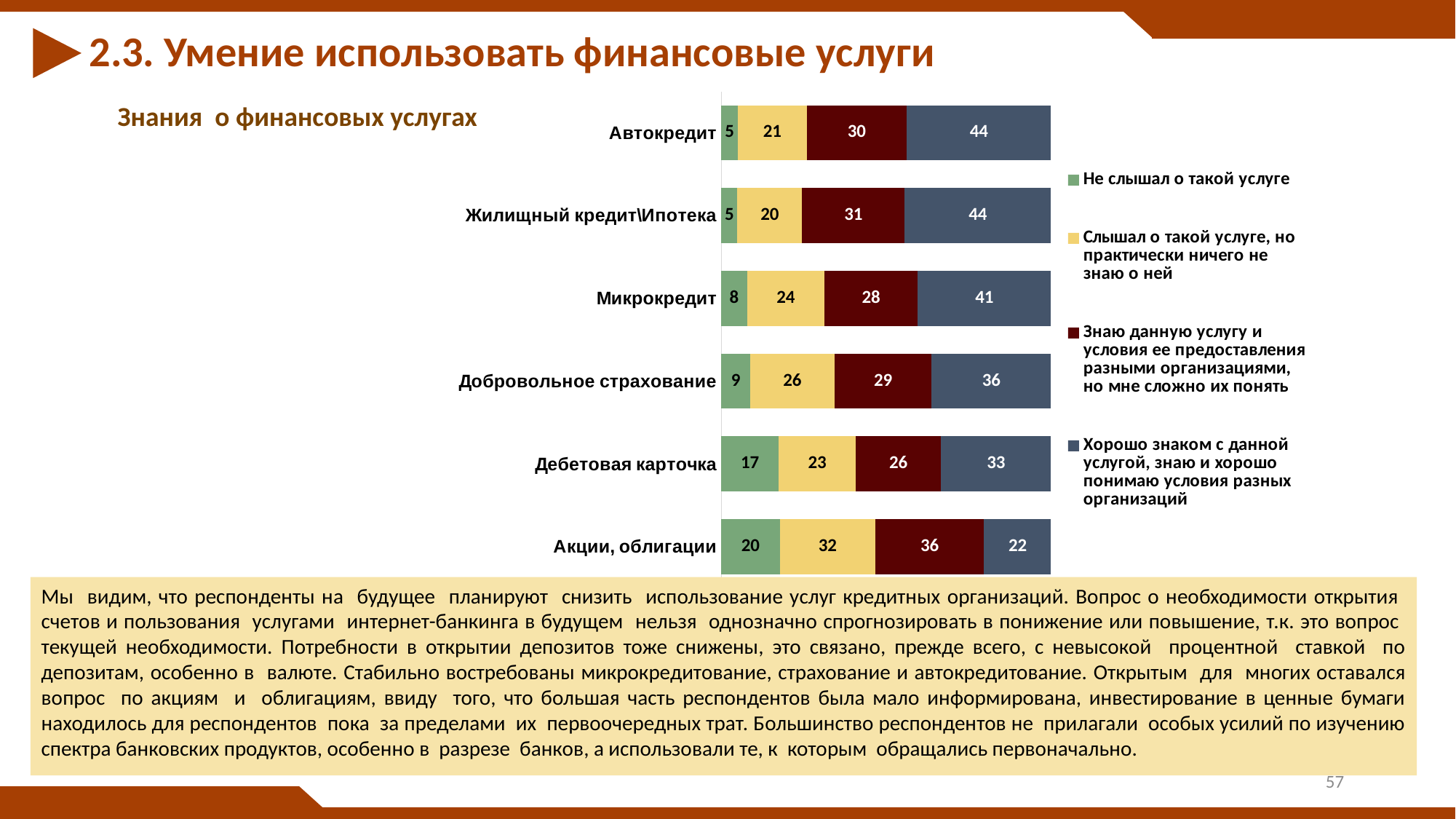
How many series does the legend list? 4 What is the difference between the "Не слышал о такой услуге" values for Дебетовая карточка and Микрокредит? 9 How many categories (financial services) are shown in the chart? 6 What is the title of the chart? Знания о финансовых услугах Which category has the highest value for "Не слышал о такой услуге"? Акции, облигации What type of chart is shown on the slide? Stacked bar chart What is the value of "Слышал о такой услуге, но практически ничего не знаю о ней" for Добровольное страхование? 26 What is the value of "Хорошо знаком с данной услугой, знаю и хорошо понимаю условия разных организаций" for Автокредит? 44 Which category has the lowest value for "Хорошо знаком с данной услугой, знаю и хорошо понимаю условия разных организаций"? Акции, облигации What is the total of the stacked bar for Автокредит? 100 Which is larger: the "Знаю данную услугу и условия ее предоставления разными организациями, но мне сложно их понять" value for Акции, облигации or for Автокредит? Акции, облигации What is the value of "Не слышал о такой услуге" for Акции, облигации? 20